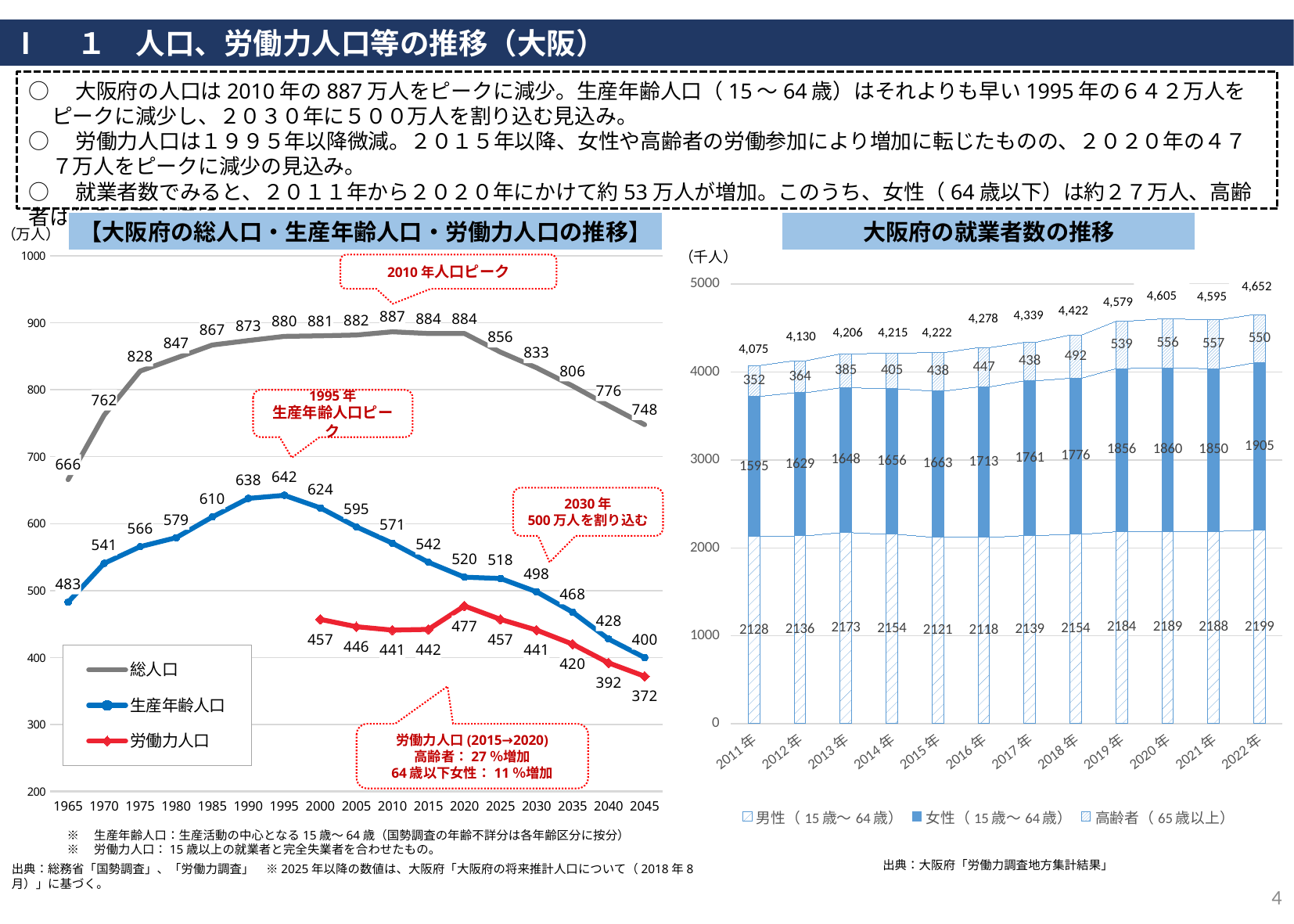
In the right chart (大阪府の就業者数の推移), what is the total for 2022年? 4,652 In the right chart (大阪府の就業者数の推移), what is the value of 女性（15歳～64歳） in 2011年? 1595 In the left chart (大阪府の総人口・生産年齢人口・労働力人口の推移), what is the value of 総人口 in 2010? 887 In the right chart (大阪府の就業者数の推移), is the value of 高齢者（65歳以上） larger in 2019年 or in 2022年? 2022年 In the right chart (大阪府の就業者数の推移), which year has the lowest total? 2011年 In the left chart (大阪府の総人口・生産年齢人口・労働力人口の推移), what is the difference between 生産年齢人口 in 1995 and in 2045? 242 In the left chart (大阪府の総人口・生産年齢人口・労働力人口の推移), how many series does the legend list? 3 In the left chart (大阪府の総人口・生産年齢人口・労働力人口の推移), what kind of chart is it? line chart In the left chart (大阪府の総人口・生産年齢人口・労働力人口の推移), what is the value of 労働力人口 in 2045? 372 In the left chart (大阪府の総人口・生産年齢人口・労働力人口の推移), in which year does 総人口 reach its highest value? 2010 In the right chart (大阪府の就業者数の推移), how many years are shown on the x axis? 12 In the left chart (大阪府の総人口・生産年齢人口・労働力人口の推移), what is the value of 生産年齢人口 in 1995? 642